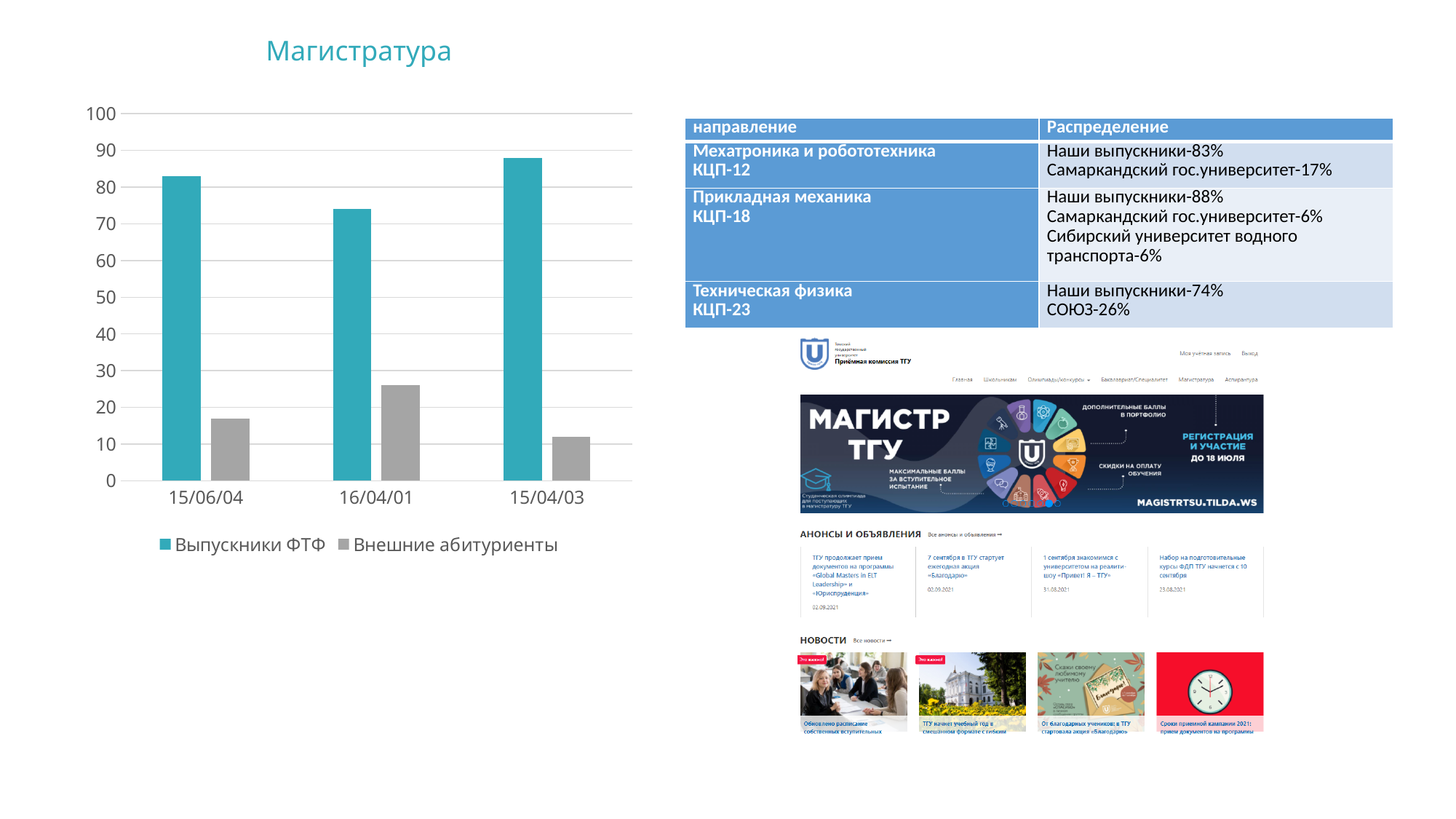
Is the value for Выпускники ФТФ at 15/06/04 greater or less than 80? greater Is the value for Выпускники ФТФ at 16/04/01 greater or less than 80? less Which category has the highest value for Выпускники ФТФ in the bar chart? 15/04/03 In the bar chart, which is larger at 15/04/03: Выпускники ФТФ or Внешние абитуриенты? Выпускники ФТФ Is the value for Внешние абитуриенты at 16/04/01 greater or less than 20? greater How many series does the legend of the bar chart list? 2 What colour are the bars for Внешние абитуриенты in the bar chart? grey Which category has the lowest value for Выпускники ФТФ in the bar chart? 16/04/01 Which category has the lowest value for Внешние абитуриенты in the bar chart? 15/04/03 How many categories are shown on the x axis of the bar chart? 3 Which category has the highest value for Внешние абитуриенты in the bar chart? 16/04/01 What kind of chart is shown on the left of the slide? bar chart